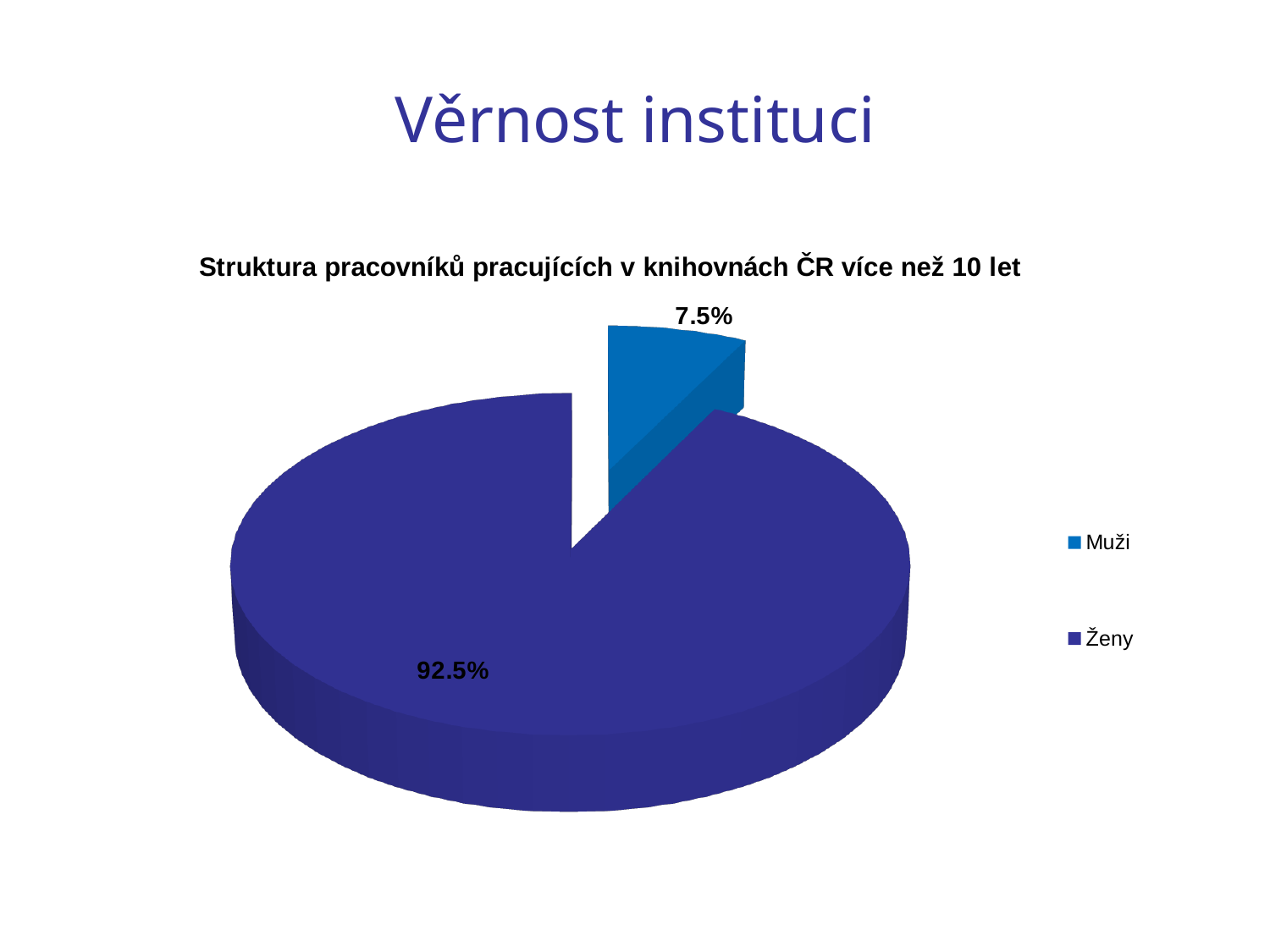
What percentage is shown for Muži? 7.5% What is the difference in percentage points between Ženy and Muži? 85 What is the chart's title? Struktura pracovníků pracujících v knihovnách ČR více než 10 let Which category has the smallest share of the pie? Muži Which category has the largest share of the pie? Ženy How many slices does the pie chart have? 2 How many entries does the legend list? 2 Which is larger, the share for Muži or the share for Ženy? Ženy What kind of chart is shown on the slide? pie chart What percentage is shown for Ženy? 92.5% Which legend entry is shown in the lighter blue colour? Muži What share of the pie does the Ženy slice represent? 92.5%